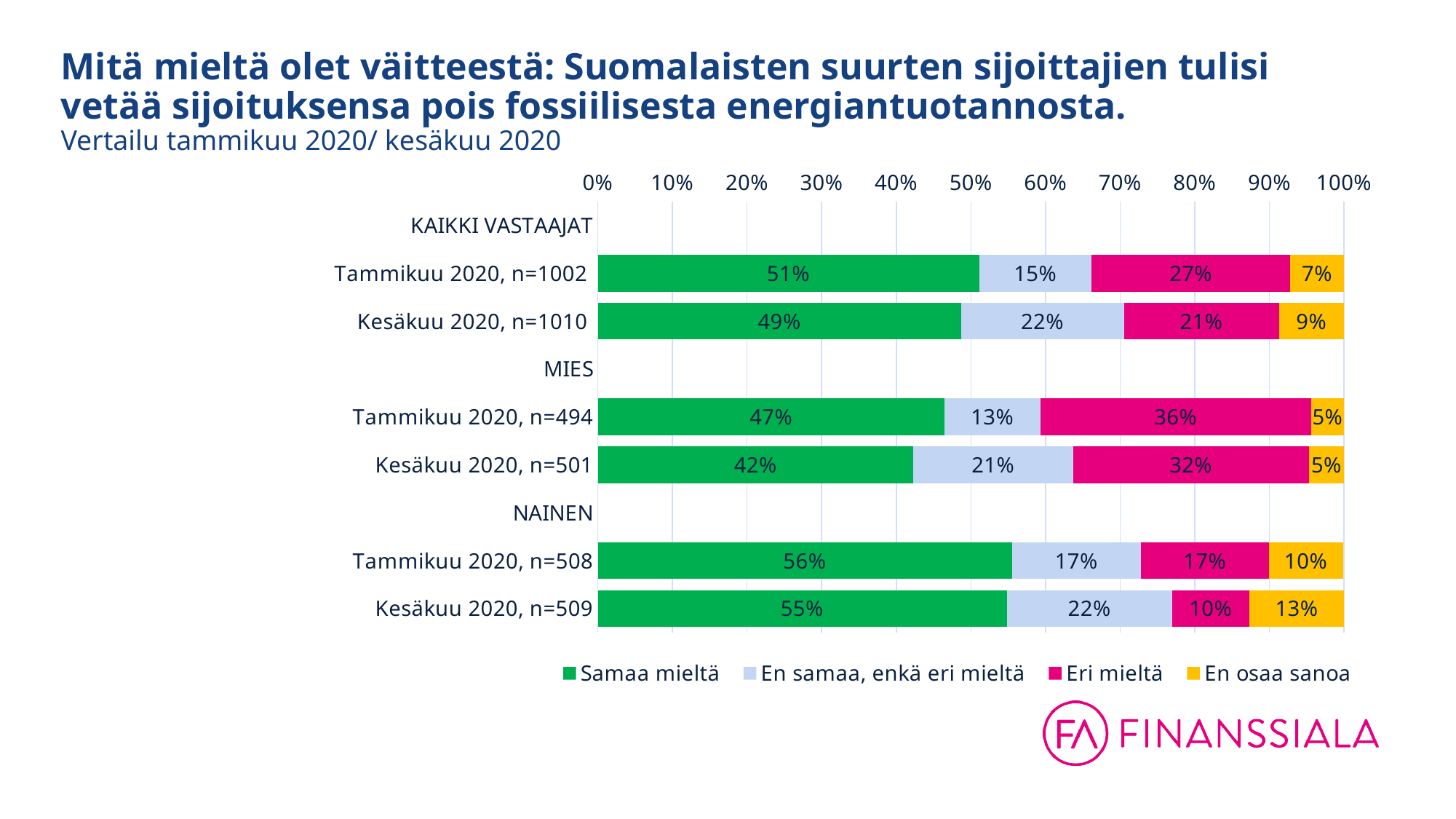
How many series does the legend list? 4 Which bar has the highest "Samaa mieltä" share? Nainen, Tammikuu 2020, n=508 What is the total of the stacked bar for men (Mies) in Tammikuu 2020, n=494? 101% What is the "En samaa, enkä eri mieltä" value for all respondents in Kesäkuu 2020, n=1010? 22% Which bar has the lowest "Eri mieltä" share? Nainen, Kesäkuu 2020, n=509 How many data bars are plotted in the chart? 6 What is the "En osaa sanoa" value for women (Nainen) in Kesäkuu 2020, n=509? 13% By how many percentage points did the "Eri mieltä" share among all respondents change from Tammikuu 2020 to Kesäkuu 2020? 6 percentage points (27% to 21%) What is the "Eri mieltä" value for men (Mies) in Tammikuu 2020, n=494? 36% What kind of chart is shown on the slide? Stacked horizontal bar chart Which is larger: the "Samaa mieltä" share for men in Kesäkuu 2020 or for women in Kesäkuu 2020? Women (Nainen), Kesäkuu 2020 (55% vs 42%) What percentage of all respondents (Kaikki vastaajat) in Tammikuu 2020, n=1002 answered "Samaa mieltä"? 51%